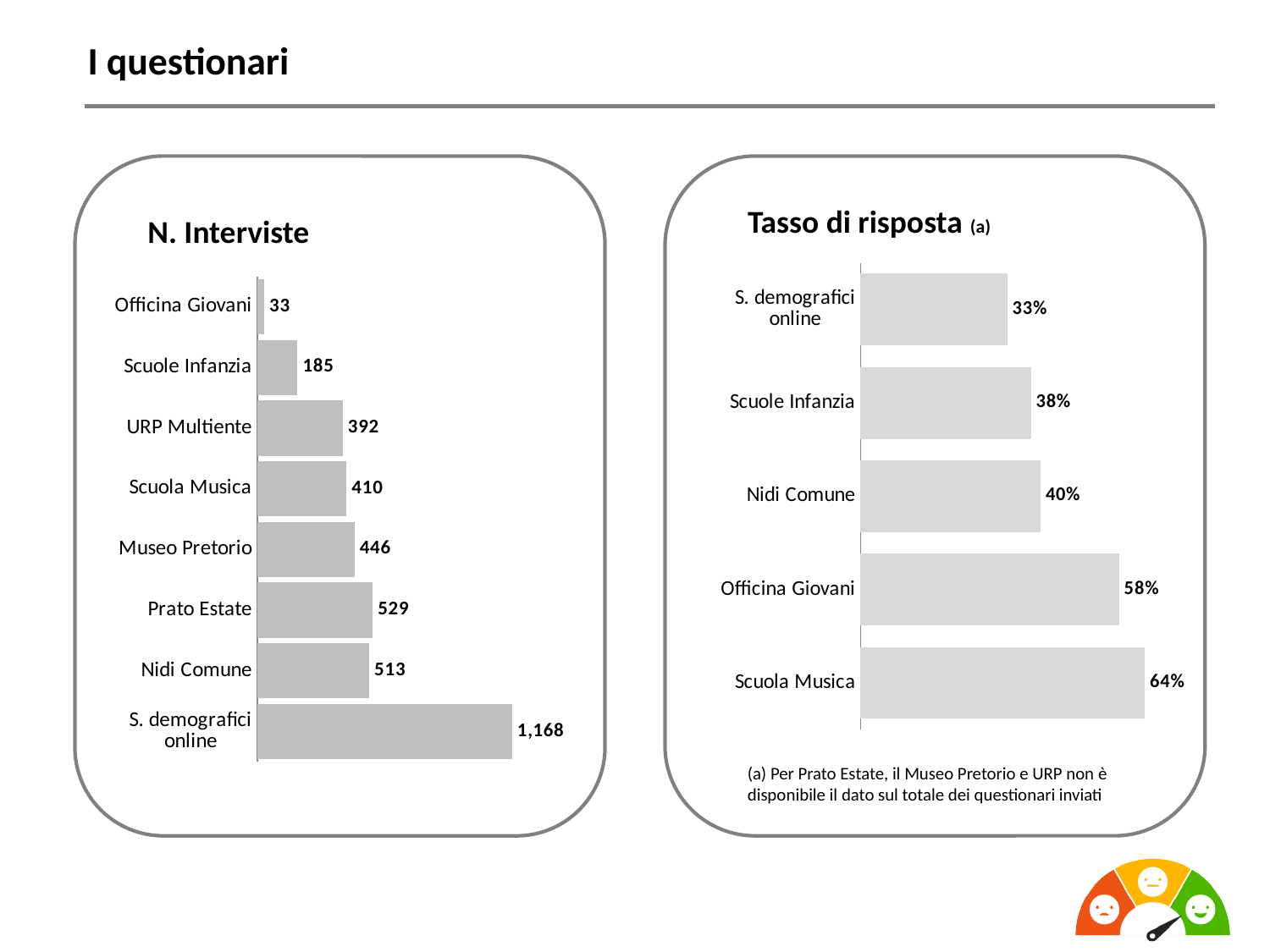
In the 'N. Interviste' chart, what is the difference between Prato Estate and Nidi Comune? 16 In the 'Tasso di risposta' chart, how many categories are shown? 5 In the 'N. Interviste' chart, what is the value for S. demografici online? 1,168 In the 'N. Interviste' chart, what is the value for Scuola Musica? 410 In the 'Tasso di risposta' chart, which category has the lowest value? S. demografici online In the 'N. Interviste' chart, how many categories are shown? 8 In the 'N. Interviste' chart, which category has the highest value? S. demografici online In the 'N. Interviste' chart, which category has the lowest value? Officina Giovani In the 'Tasso di risposta' chart, what is the value for Nidi Comune? 40% What type of chart is the 'N. Interviste' chart? Bar chart In the 'Tasso di risposta' chart, which category has the highest value? Scuola Musica In the 'Tasso di risposta' chart, what is the difference between Officina Giovani and Scuole Infanzia? 20%